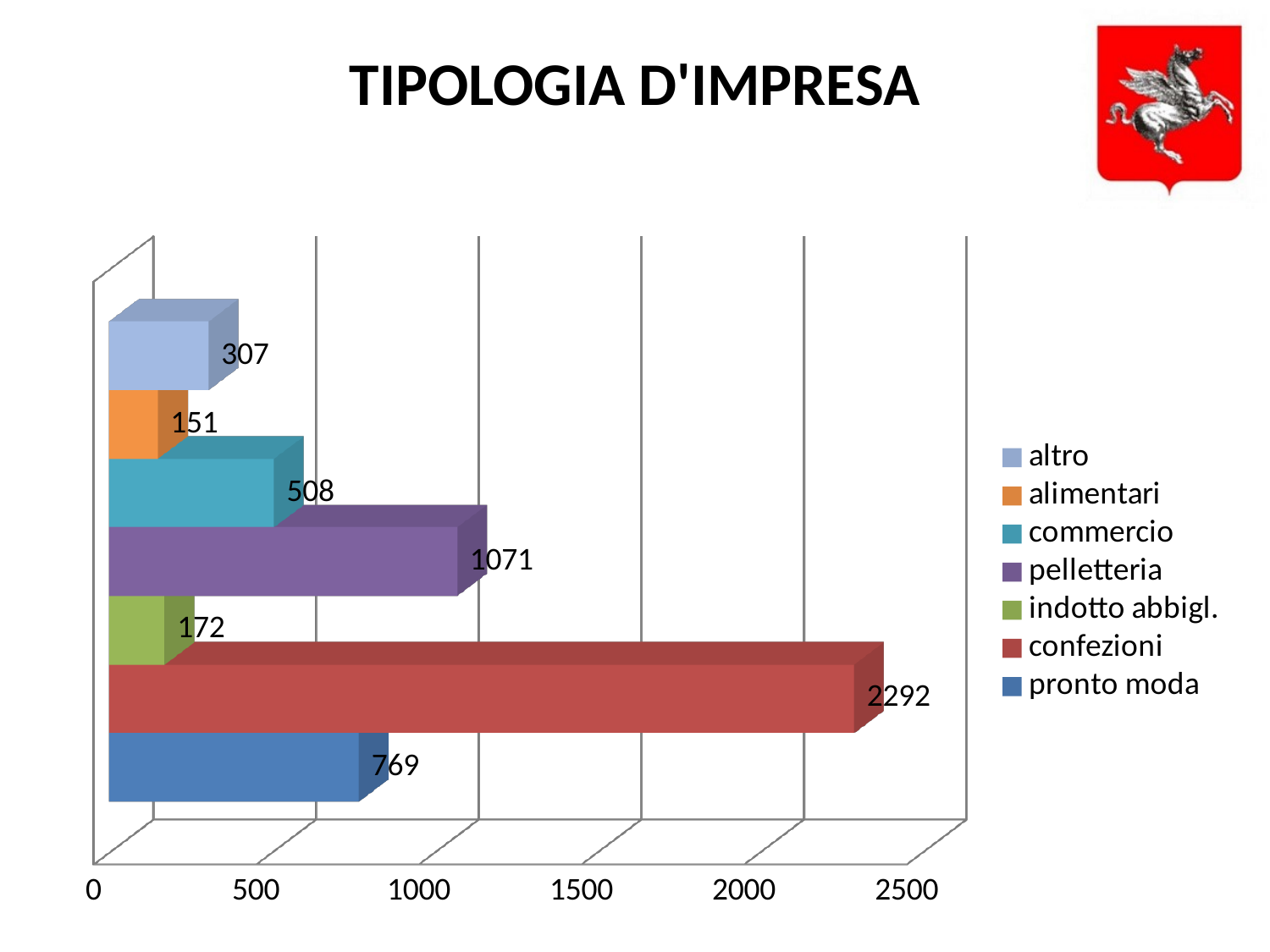
What is the value for pelletteria? 1071 What is the value for pronto moda? 769 Which category has the highest value? confezioni Which category has the lowest value? alimentari What is the difference between the values for confezioni and pronto moda? 1523 How many entries does the legend list? 7 What is the value for confezioni? 2292 What is the title of the chart? TIPOLOGIA D'IMPRESA How many categories are shown in the chart? 7 What kind of chart is shown on the slide? bar chart What is the value for alimentari? 151 Which is larger, the value for commercio or the value for altro? commercio